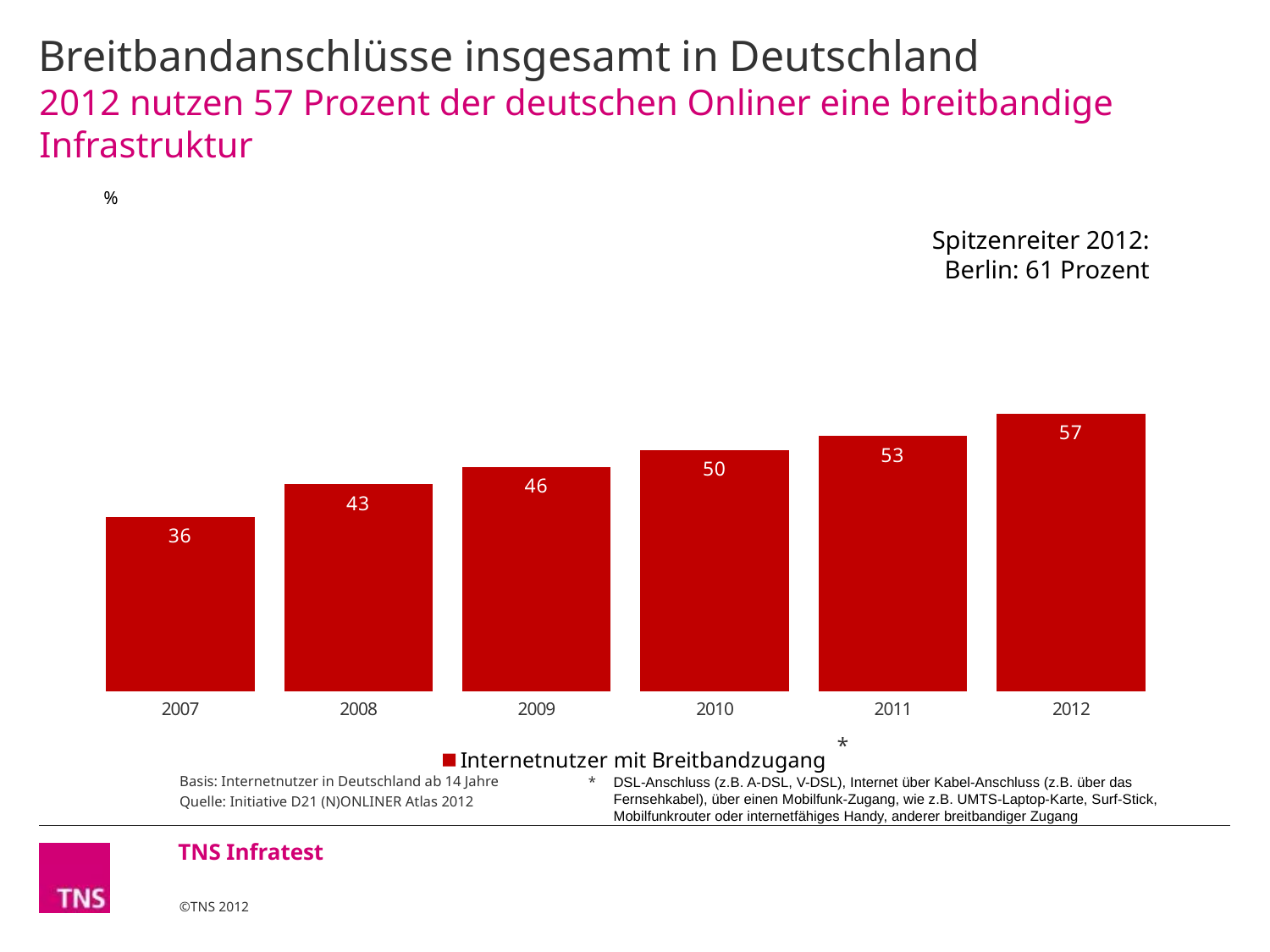
Do the values rise or fall from 2007 to 2012? rise What is the value for 2010? 50 Which year has the lowest value? 2007 How many series does the legend list? 1 What is the difference between the values for 2009 and 2008? 3 Which year has the highest value? 2012 What is the value for 2007? 36 How many years are shown on the x axis? 6 What kind of chart is shown? bar chart What is the value for 2012? 57 What is the difference between the values for 2012 and 2007? 21 Which is larger, the value for 2011 or the value for 2009? 2011